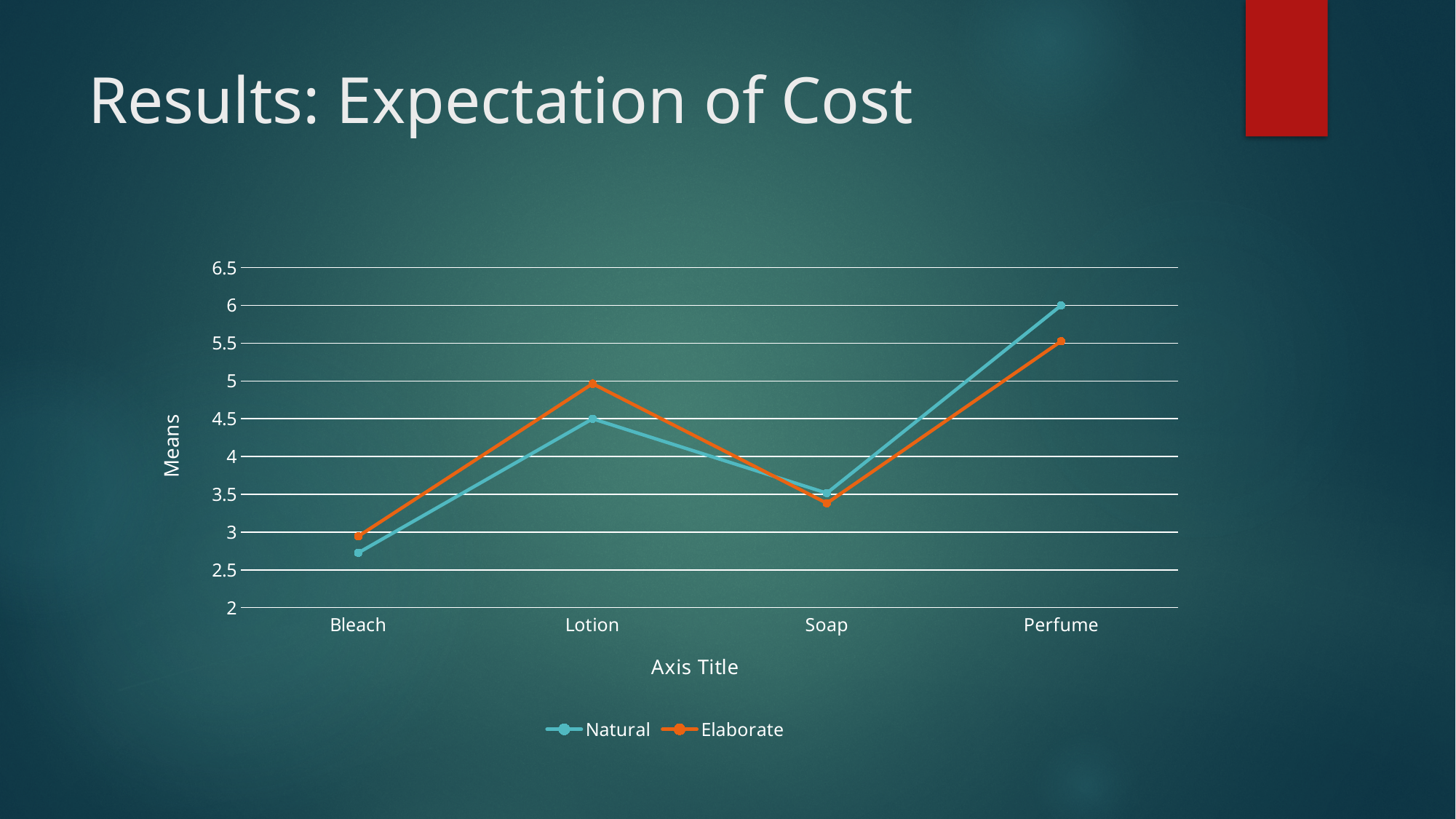
How many categories are shown on the x axis? 4 Is the value for Natural at Bleach greater or less than 3? less Is the value for Elaborate at Perfume greater or less than 5? greater For which category is the Elaborate series highest? Perfume For which category is the Elaborate series lowest? Bleach Do the values for both series rise or fall from Soap to Perfume? rise At Lotion, which series has the larger value, Natural or Elaborate? Elaborate How many series does the legend list? 2 What is the title of the vertical axis? Means What kind of chart is shown on the slide? line chart For which category is the Natural series highest? Perfume At Perfume, which series has the larger value, Natural or Elaborate? Natural